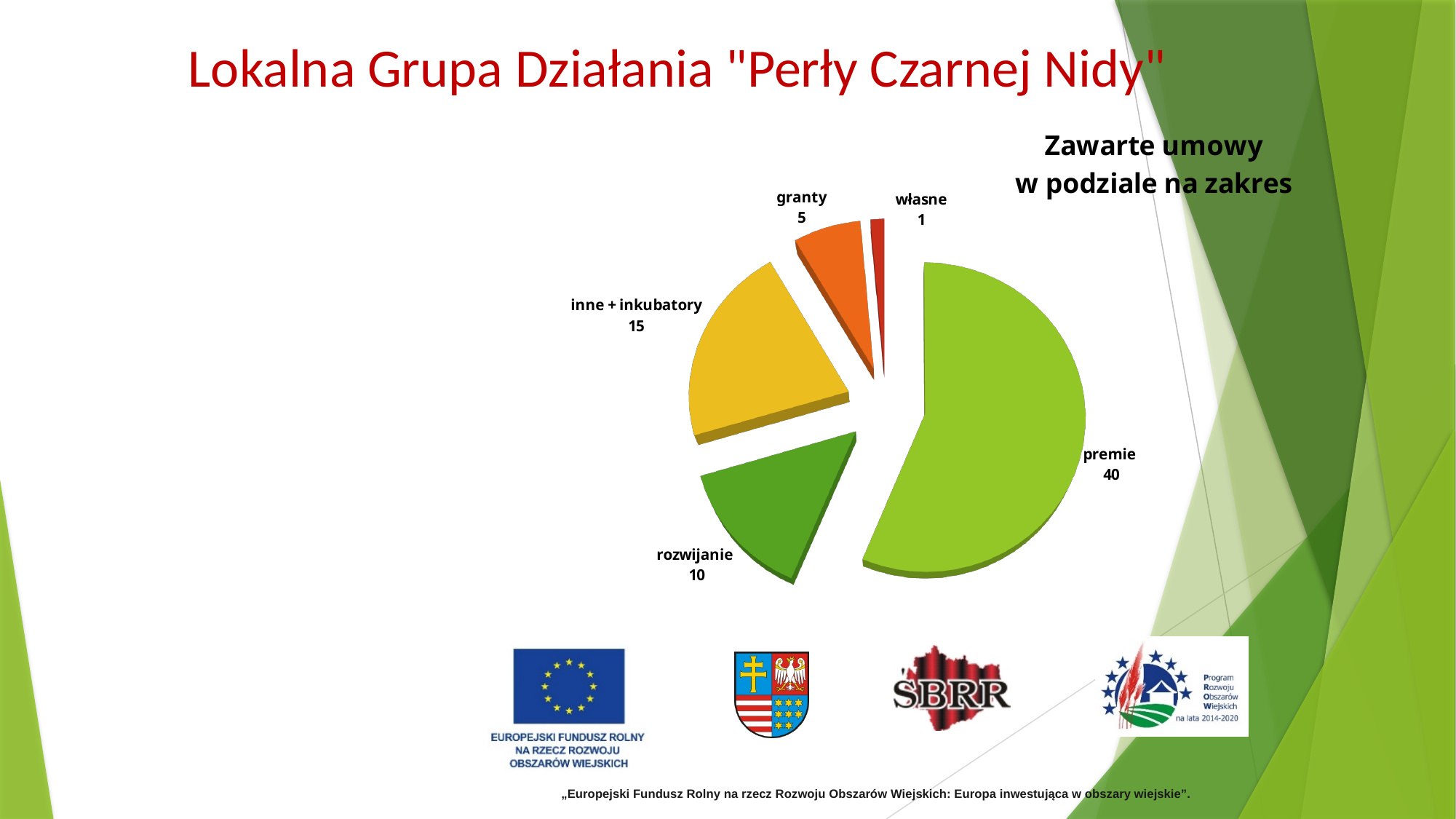
Which category has the smallest slice? własne Which is larger, rozwijanie or granty? rozwijanie What is the value for rozwijanie? 10 What is the value for premie? 40 What type of chart is shown on the slide? pie chart What is the difference between the values for premie and inne + inkubatory? 25 Which category has the largest slice? premie What is the value for inne + inkubatory? 15 What is the total of all slices in the pie chart? 71 What is the value for granty? 5 What is the title of the pie chart? Zawarte umowy w podziale na zakres How many slices does the pie chart have? 5